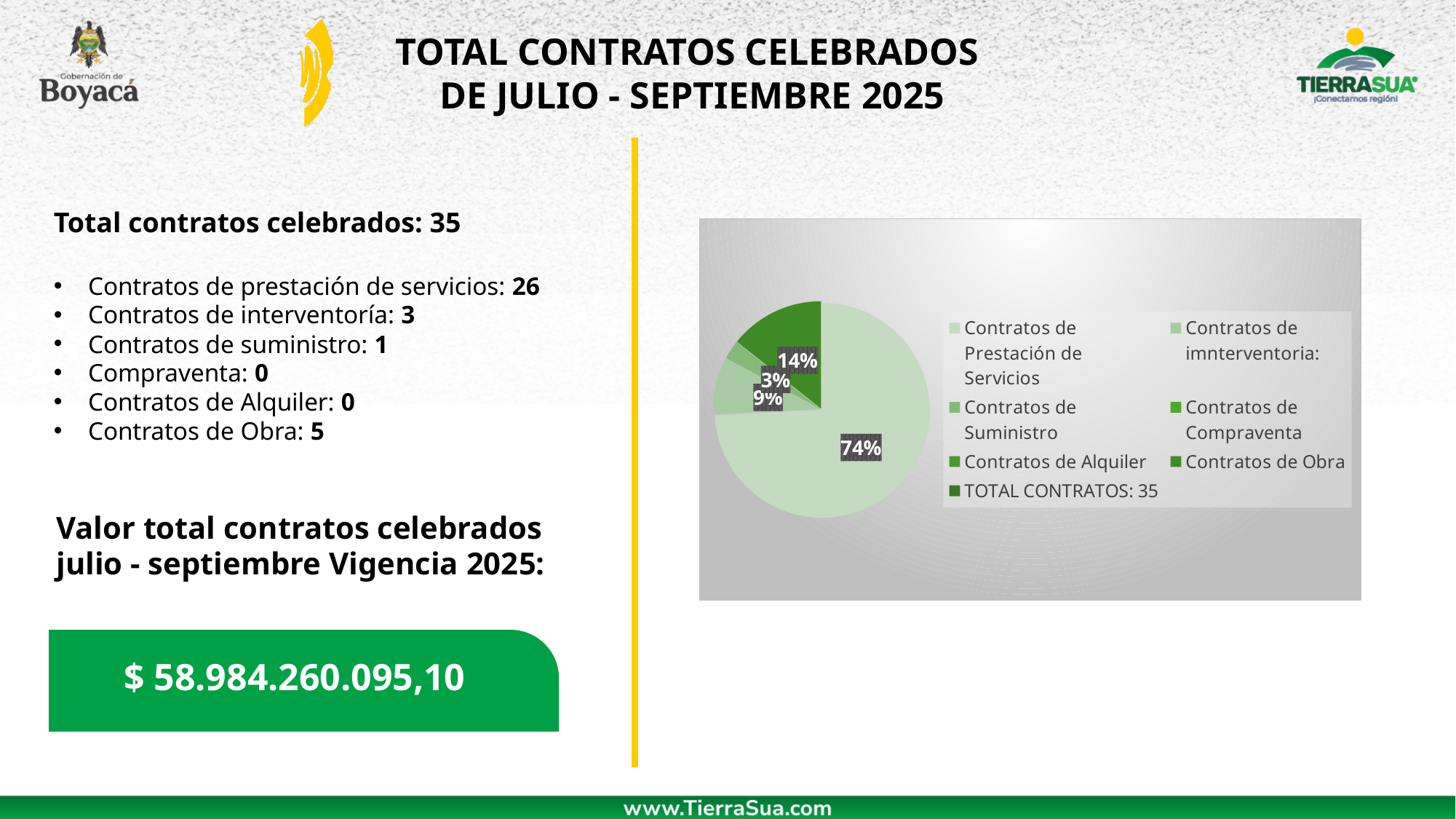
Which labelled slice of the pie chart is the smallest? Contratos de Suministro What is the difference in percentage points between the 74% slice and the 14% slice in the pie chart? 60 What percentage is shown for Contratos de Suministro in the pie chart? 3% Which category has the largest slice of the pie chart? Contratos de Prestación de Servicios What kind of chart is shown on the slide? pie chart How many percentage labels are printed on the pie chart? 4 What total number of contracts does the legend of the pie chart state? 35 What percentage is shown for the largest slice of the pie chart? 74% What percentage is shown for Contratos de interventoria in the pie chart? 9% Which is larger in the pie chart: the slice for Contratos de Obra or the slice for Contratos de interventoria? Contratos de Obra What percentage is shown for Contratos de Obra in the pie chart? 14% How many entries does the legend of the pie chart list? 7